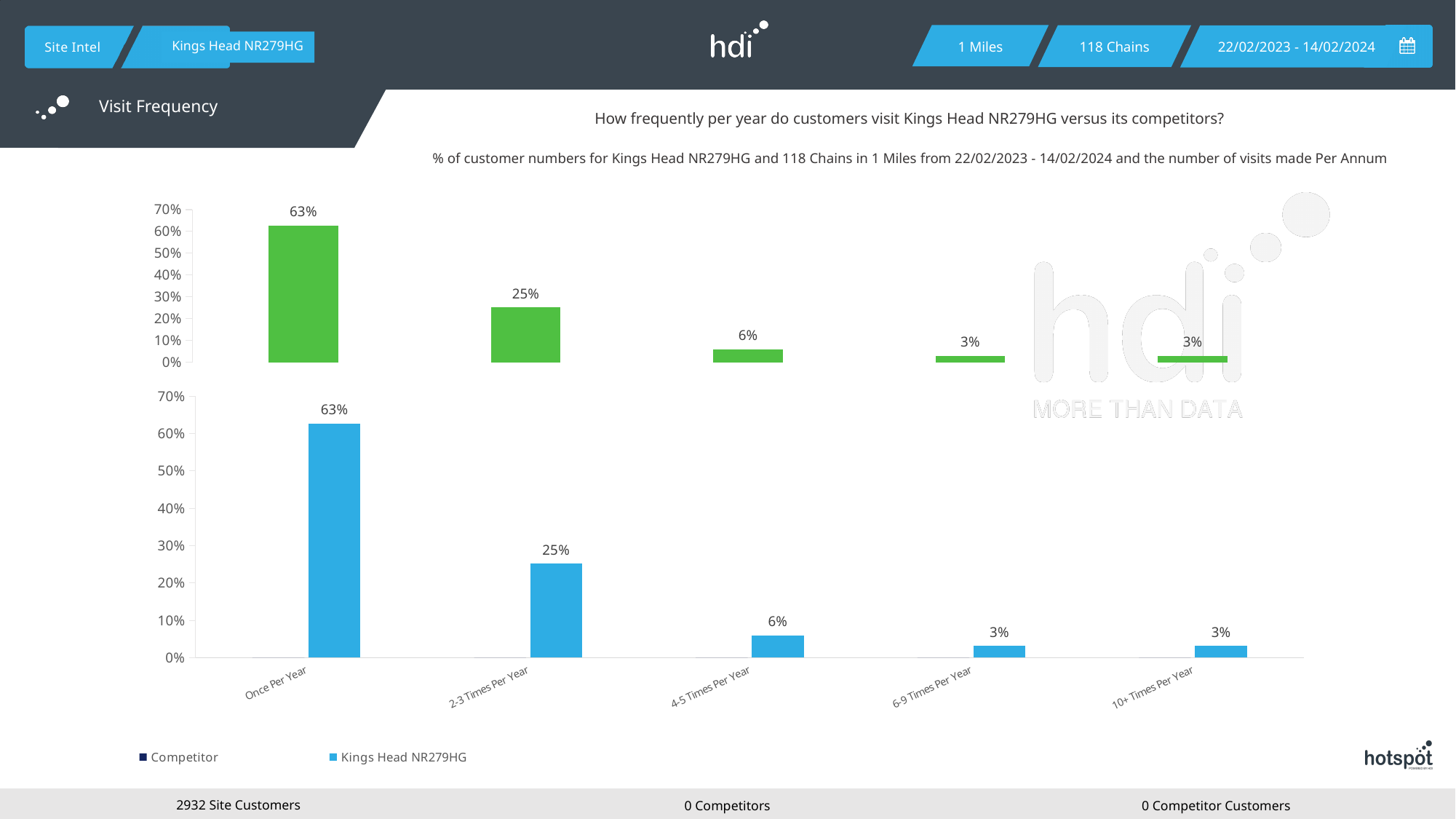
On the bottom chart, what is the value for 4-5 Times Per Year? 6% On the top chart, what is the value shown on the first (tallest) bar? 63% On the bottom chart, what is the value for 10+ Times Per Year? 3% On the bottom chart, do the values rise or fall from Once Per Year to 10+ Times Per Year? fall What kind of chart is the bottom chart? bar chart How many series does the legend at the bottom of the slide list? 2 On the bottom chart, what is the difference between the values for Once Per Year and 2-3 Times Per Year? 38% On the bottom chart, what is the value for 2-3 Times Per Year? 25% On the bottom chart, which is larger, the value for 2-3 Times Per Year or the value for 4-5 Times Per Year? 2-3 Times Per Year On the bottom chart, which category has the highest value? Once Per Year How many categories are shown on the x axis of the bottom chart? 5 On the bottom chart, what is the value for Once Per Year? 63%